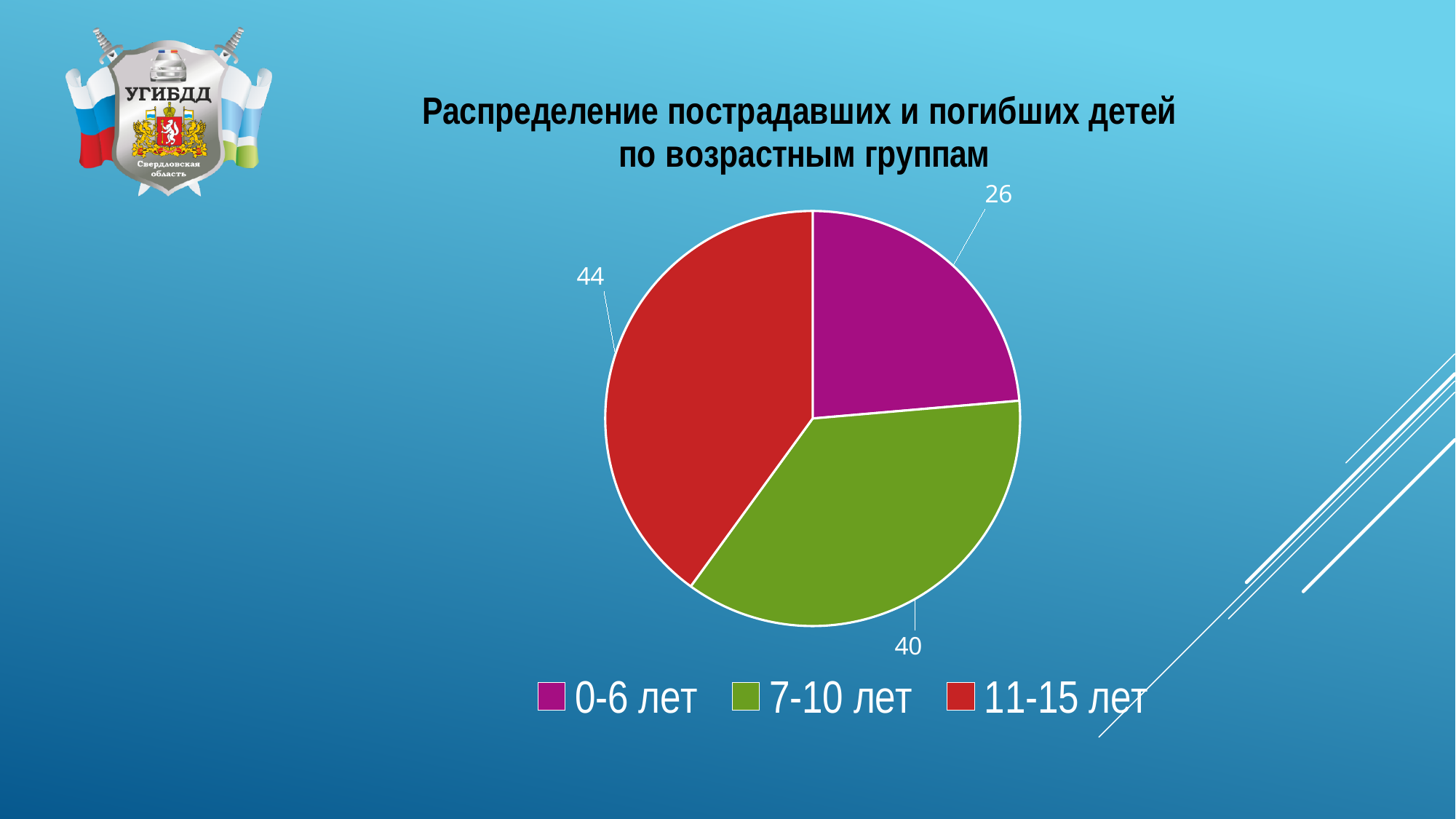
What share of the pie does the 11-15 лет slice represent? 40% Which is larger, the value for 7-10 лет or the value for 0-6 лет? 7-10 лет What is the value for the 7-10 лет slice? 40 What is the value for the 11-15 лет slice? 44 Which age group has the smallest slice? 0-6 лет What kind of chart is shown on the slide? pie chart What colour is the 7-10 лет slice? green What is the difference between the values for 7-10 лет and 0-6 лет? 14 How many slices does the pie chart have? 3 Which age group has the largest slice? 11-15 лет What is the difference between the values for 11-15 лет and 0-6 лет? 18 What is the value for the 0-6 лет slice? 26